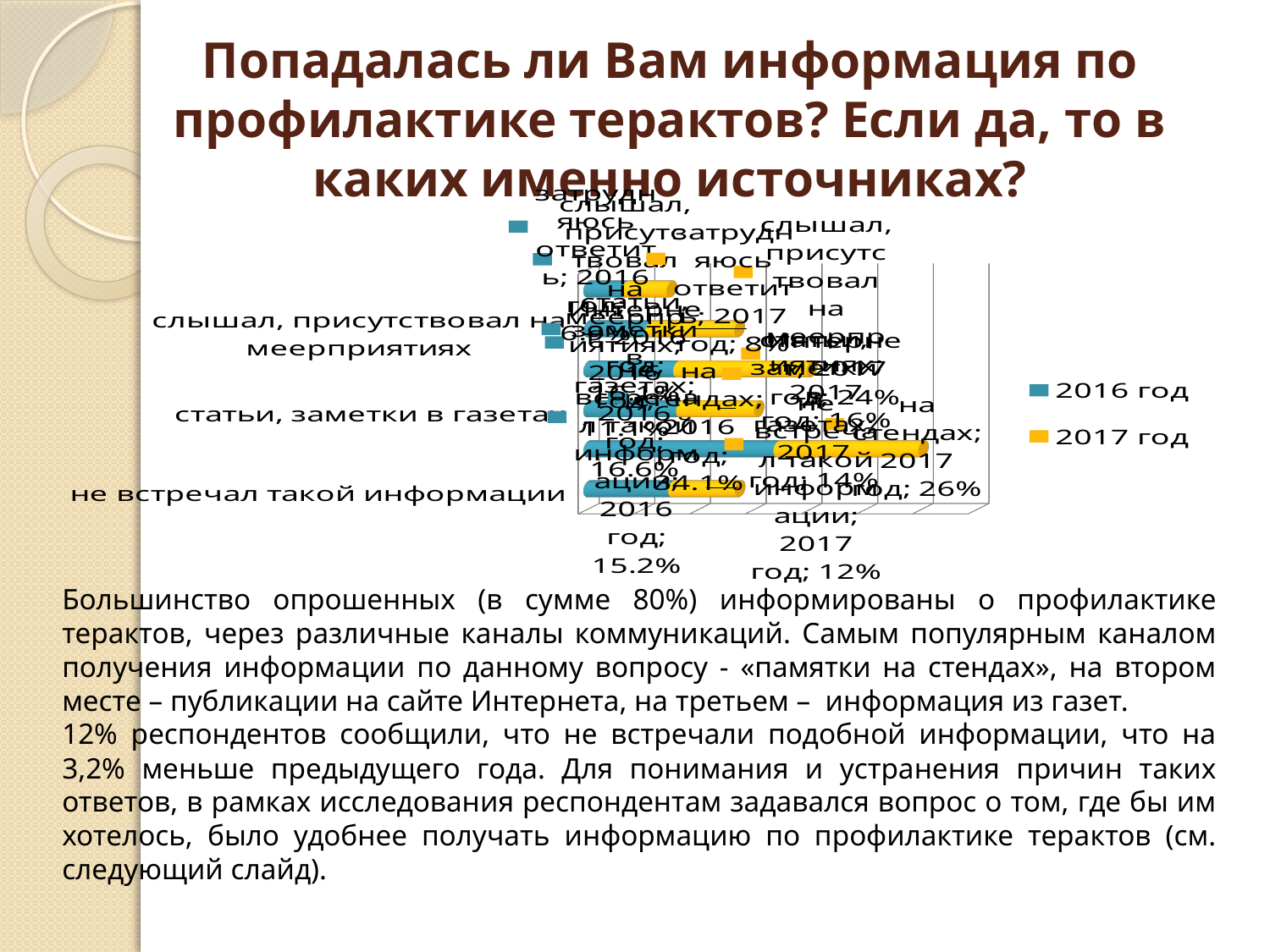
What is the value for 'не встречал такой информации' in the 2016 год series? 15.2% Which colour represents the 2017 год series in the chart? yellow For 'не встречал такой информации', which series has the larger value, 2016 год or 2017 год? 2016 год What kind of chart is shown on the slide? bar chart What is the difference between the 2016 год and 2017 год values for 'не встречал такой информации'? 3.2% How many series does the chart legend list? 2 What is the value for 'не встречал такой информации' in the 2017 год series? 12% What are the two series named in the chart legend? 2016 год and 2017 год